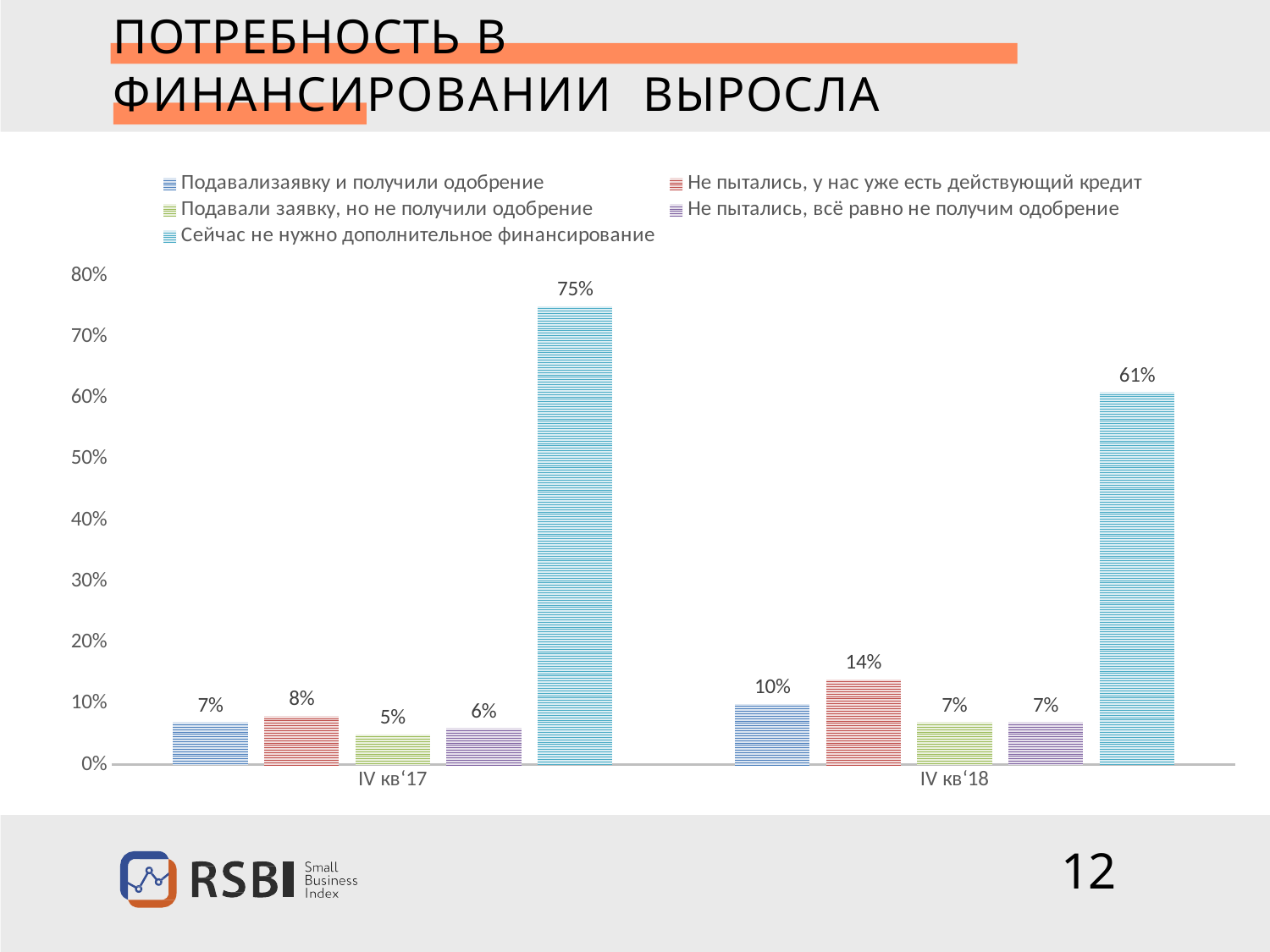
How many series does the legend list? 5 What type of chart is shown on the slide? Bar chart Does the value for 'Сейчас не нужно дополнительное финансирование' fall or rise from IV кв'17 to IV кв'18? Fall What is the value for 'Подавали заявку, но не получили одобрение' in IV кв'17? 5% What is the difference between the 'Сейчас не нужно дополнительное финансирование' values for IV кв'17 and IV кв'18? 14% What is the value for 'Сейчас не нужно дополнительное финансирование' in IV кв'18? 61% Which series has the highest value in IV кв'18? Сейчас не нужно дополнительное финансирование What is the value for 'Сейчас не нужно дополнительное финансирование' in IV кв'17? 75% Which series has the lowest value in IV кв'17? Подавали заявку, но не получили одобрение Which is larger: 'Подавали заявку и получили одобрение' in IV кв'17 or in IV кв'18? IV кв'18 How many categories are shown on the x axis? 2 What is the value for 'Не пытались, у нас уже есть действующий кредит' in IV кв'18? 14%